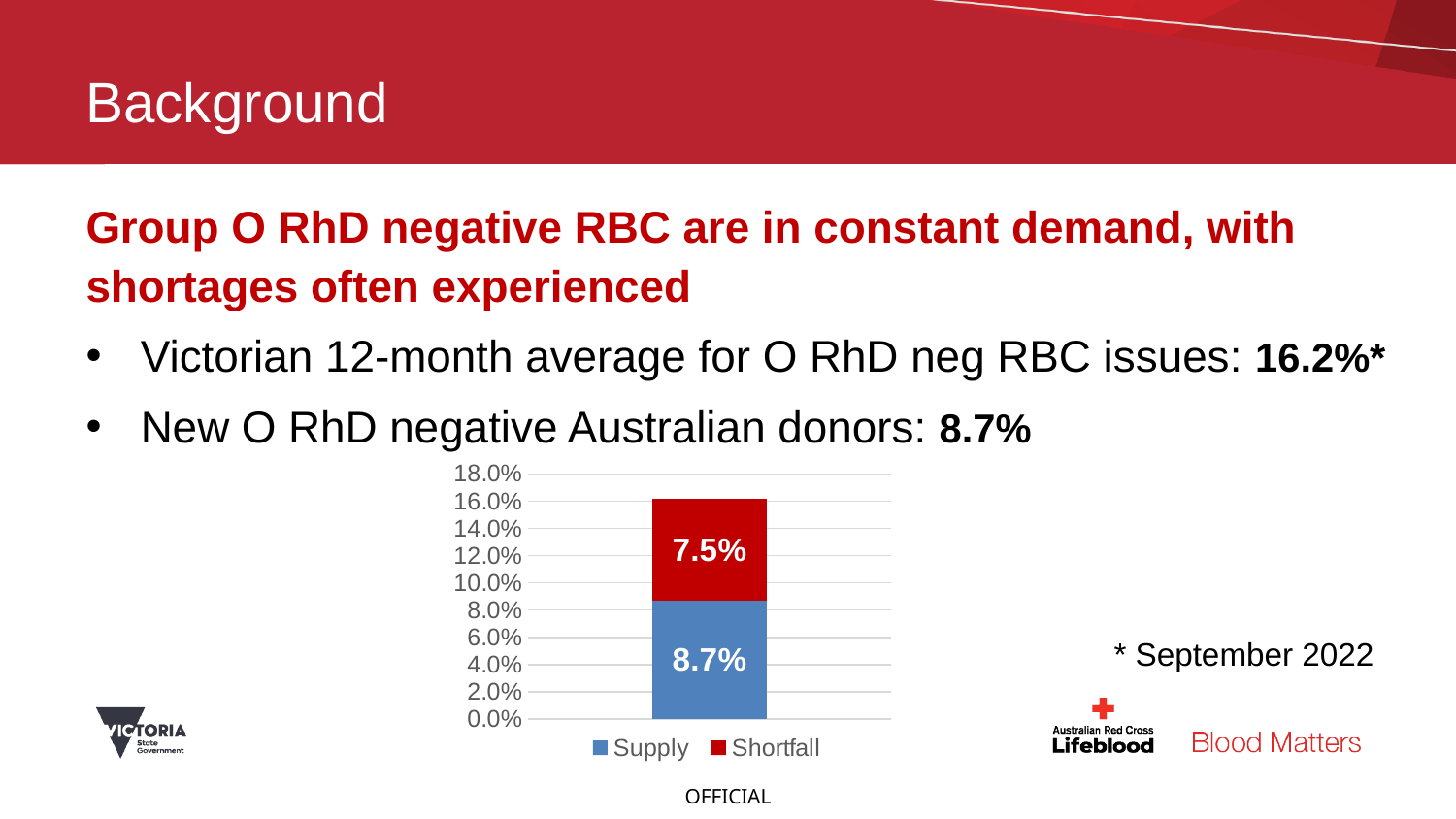
Which series has the larger value, Supply or Shortfall? Supply Is the Supply segment greater or less than 10.0%? less What is the value of the Supply segment in the stacked bar? 8.7% What is the total of the stacked bar (Supply plus Shortfall)? 16.2% What is the difference between the Supply value and the Shortfall value? 1.2% What is the value of the Shortfall segment in the stacked bar? 7.5% What kind of chart is shown on the slide? bar chart What colour is the Shortfall series in the chart? red How many bars are plotted in the chart? 1 Is the total height of the stacked bar greater or less than 14.0%? greater What is the highest value shown on the chart's vertical axis? 18.0% How many series does the chart legend list? 2